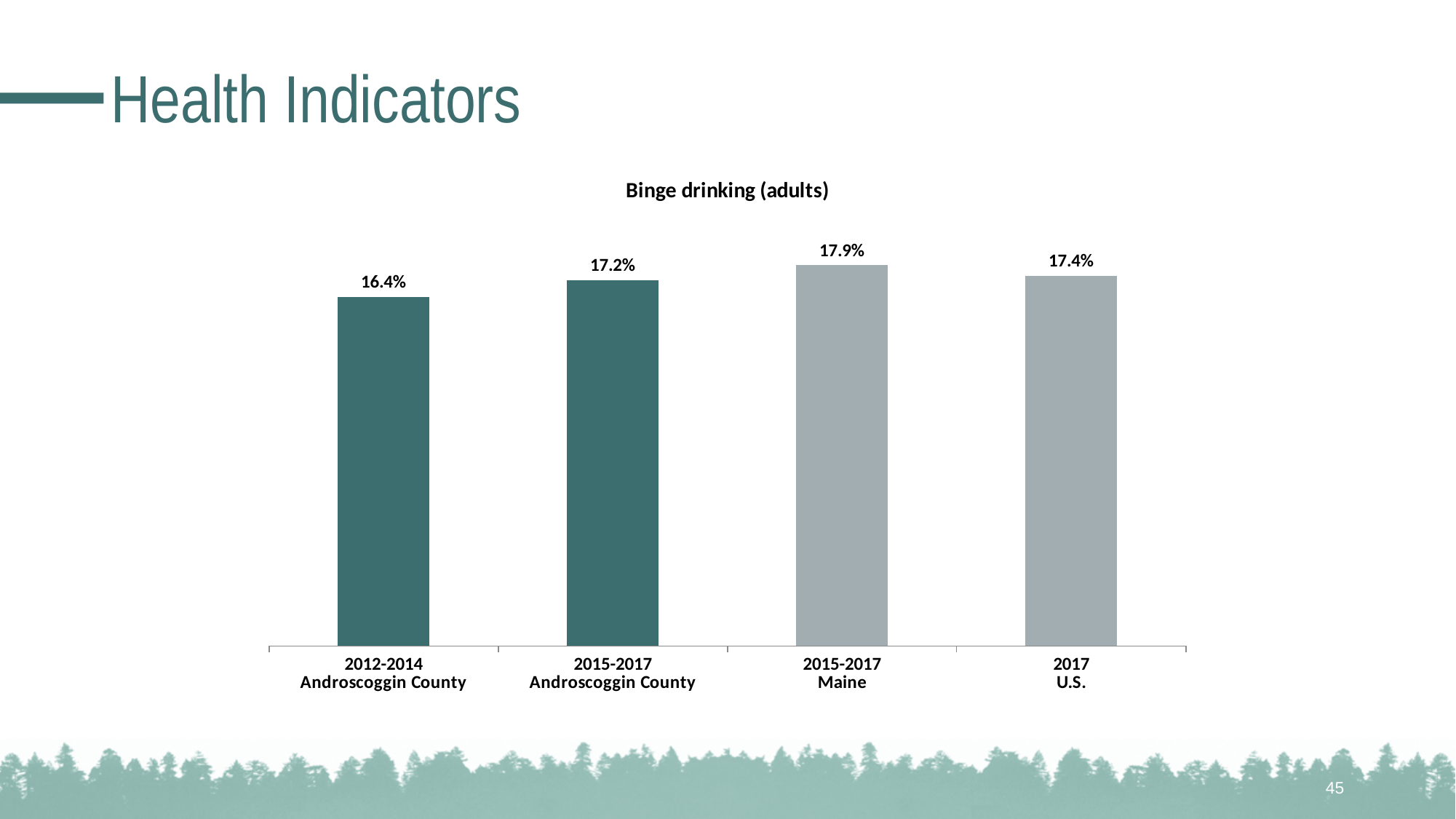
By how much did the Androscoggin County rate change from 2012-2014 to 2015-2017? 0.8% What is the binge drinking rate for Androscoggin County in 2015-2017? 17.2% What is the binge drinking rate for Androscoggin County in 2012-2014? 16.4% What is the difference between the Maine 2015-2017 rate and the Androscoggin County 2015-2017 rate? 0.7% What is the binge drinking rate for Maine in 2015-2017? 17.9% What is the title of the chart? Binge drinking (adults) How many bars are shown in the chart? 4 Which category has the highest binge drinking rate? 2015-2017 Maine Which category has the lowest binge drinking rate? 2012-2014 Androscoggin County Which is larger, the U.S. 2017 rate or the Androscoggin County 2015-2017 rate? U.S. 2017 What type of chart is shown on the slide? Bar chart What is the binge drinking rate for the U.S. in 2017? 17.4%